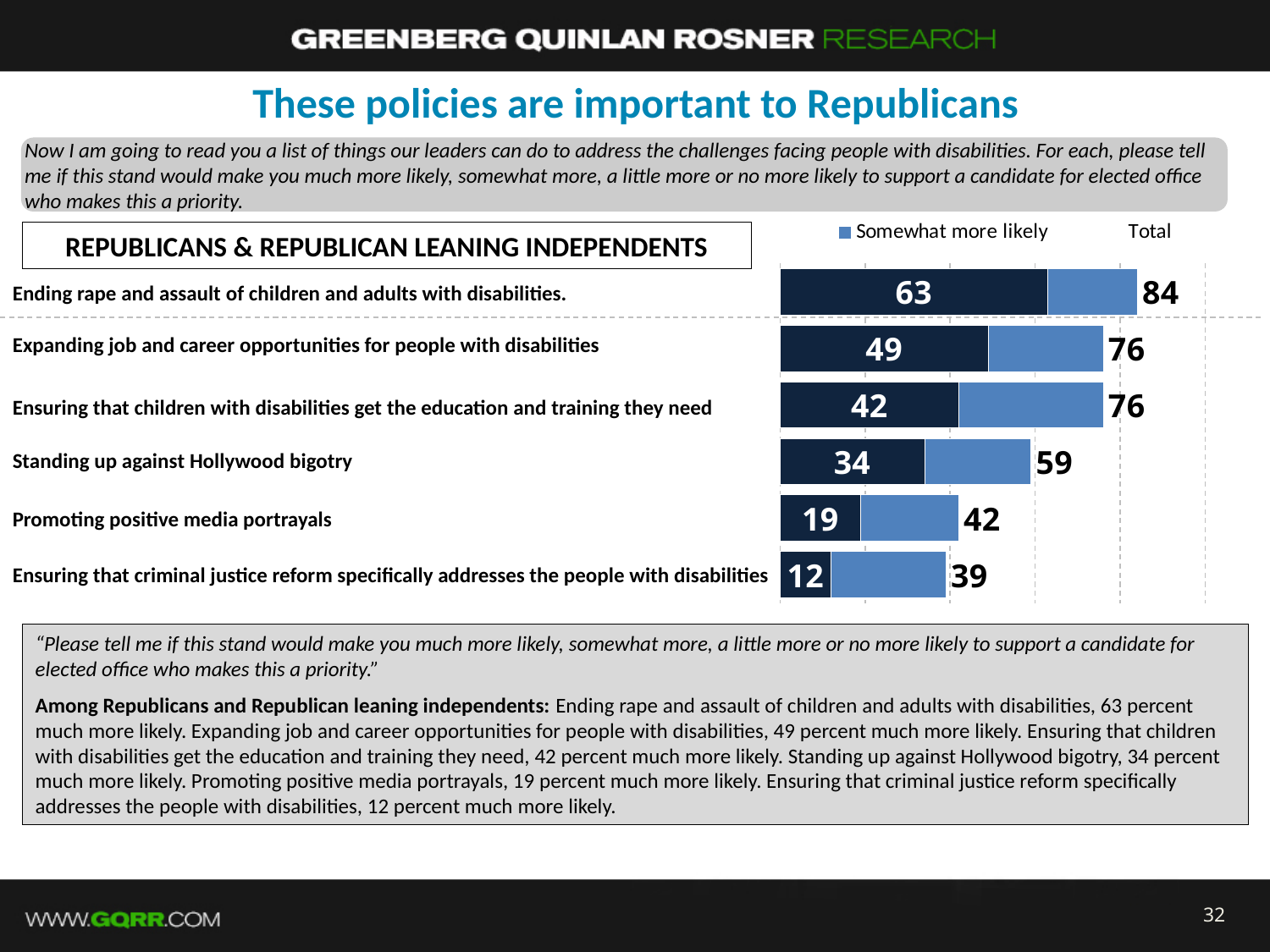
How many policies are shown in the chart? 6 What percentage of Republicans and Republican leaning independents say 'Standing up against Hollywood bigotry' would make them much more likely to support a candidate? 34 Which group of respondents does the chart cover? Republicans & Republican leaning independents Which has a larger 'much more likely' value: 'Expanding job and career opportunities for people with disabilities' or 'Ensuring that children with disabilities get the education and training they need'? Expanding job and career opportunities for people with disabilities What is the total value for 'Ending rape and assault of children and adults with disabilities.'? 84 Do the total values rise or fall going from the top policy to the bottom policy? Fall Which policy has the highest total value? Ending rape and assault of children and adults with disabilities. Based on the printed values, what is the 'somewhat more likely' share for 'Ending rape and assault of children and adults with disabilities.' (total minus much more likely)? 21 Which policy has the lowest 'much more likely' value? Ensuring that criminal justice reform specifically addresses the people with disabilities What is the difference between the total for 'Ending rape and assault of children and adults with disabilities.' and the total for 'Expanding job and career opportunities for people with disabilities'? 8 What is the total value for 'Promoting positive media portrayals'? 42 What kind of chart is shown on the slide? Stacked horizontal bar chart